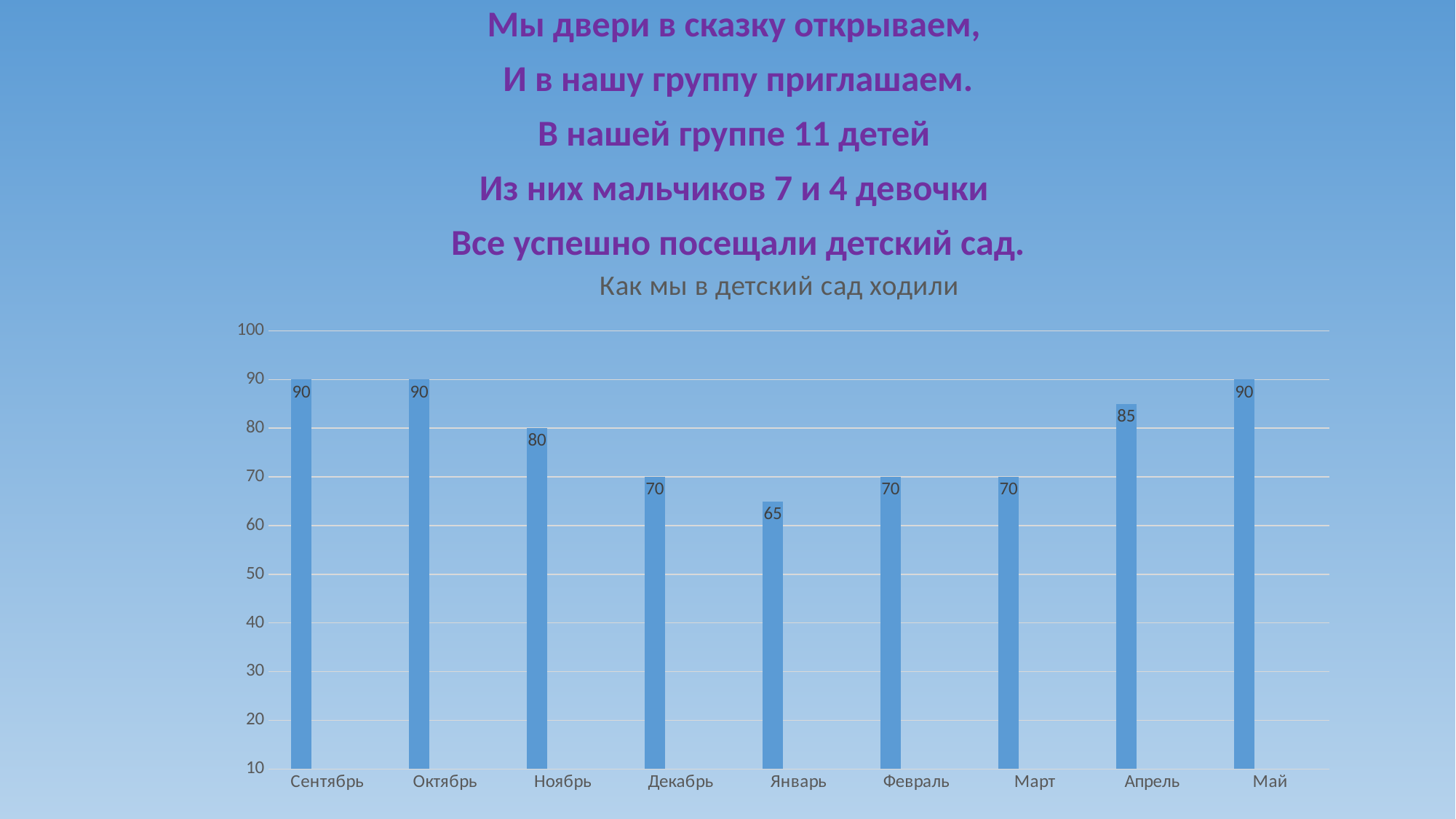
What is the value for Ноябрь? 80 What is the value for Апрель? 85 Which is larger, the value for Ноябрь or the value for Февраль? Ноябрь What is the difference between the values for Сентябрь and Январь? 25 How many months are shown on the x axis? 9 What kind of chart is shown on the slide? bar chart Which month has the lowest value? Январь What is the difference between the values for Апрель and Март? 15 What is the value for Декабрь? 70 Do the values rise or fall from Сентябрь to Январь? fall What is the title of the chart? Как мы в детский сад ходили What is the value for Январь? 65